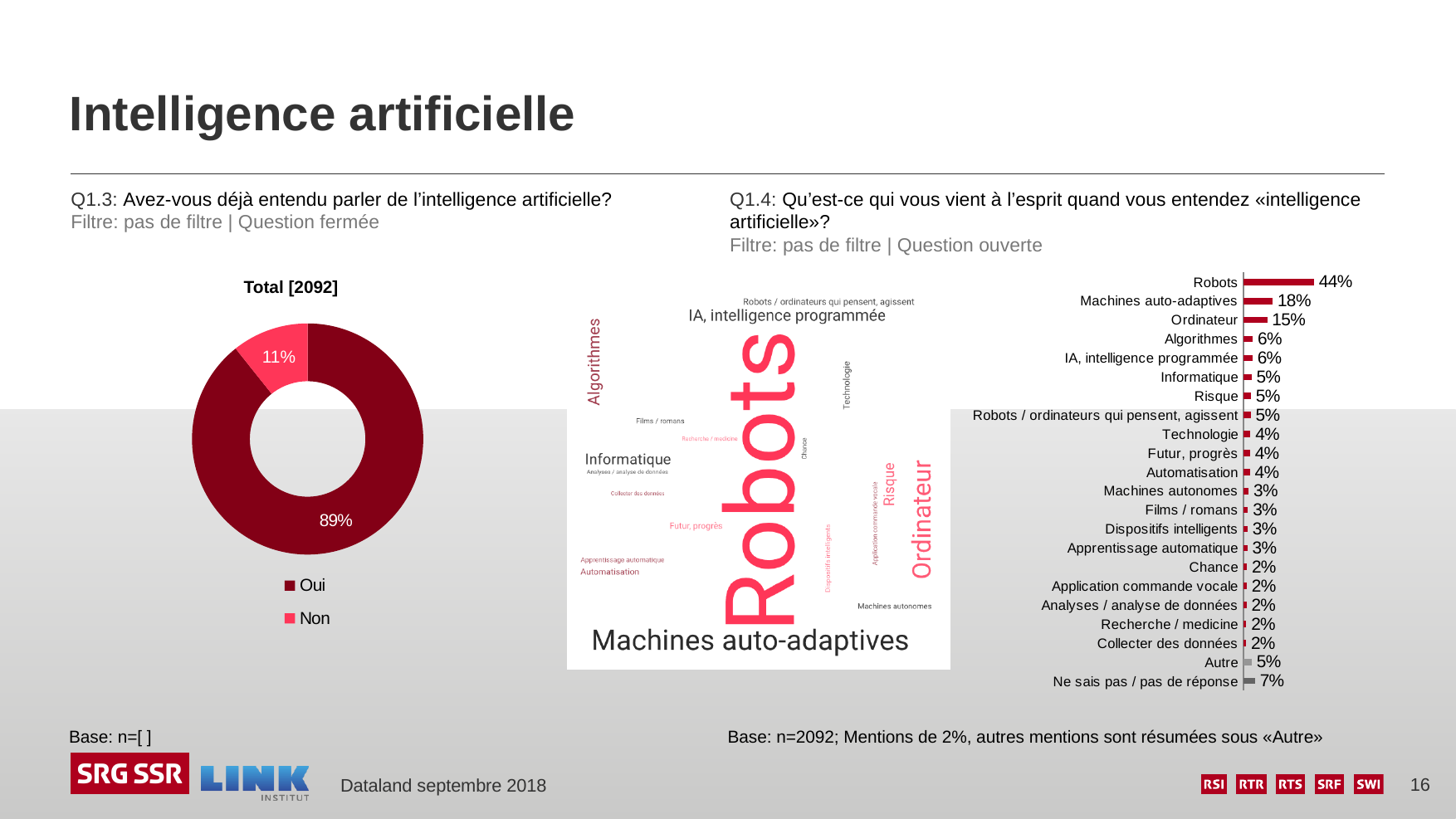
In the donut chart on the left (Q1.3), what is the difference between the "Oui" and "Non" shares? 78% In the donut chart on the left (Q1.3), what share of respondents answered "Oui"? 89% In the bar chart on the right (Q1.4), which is larger: "Ordinateur" or "Algorithmes"? Ordinateur In the donut chart on the left (Q1.3), what share of respondents answered "Non"? 11% In the donut chart on the left (Q1.3), what total is given in the chart title? Total [2092] In the bar chart on the right (Q1.4), which category has the highest value? Robots In the bar chart on the right (Q1.4), what is the value for "Machines auto-adaptives"? 18% In the bar chart on the right (Q1.4), what is the difference between "Robots" and "Ordinateur"? 29% What type of chart is shown on the right of the slide under Q1.4? Bar chart What type of chart is shown on the left of the slide under Q1.3? Donut (pie) chart In the bar chart on the right (Q1.4), what is the value for "Ne sais pas / pas de réponse"? 7% In the bar chart on the right (Q1.4), what is the value for "Robots"? 44%